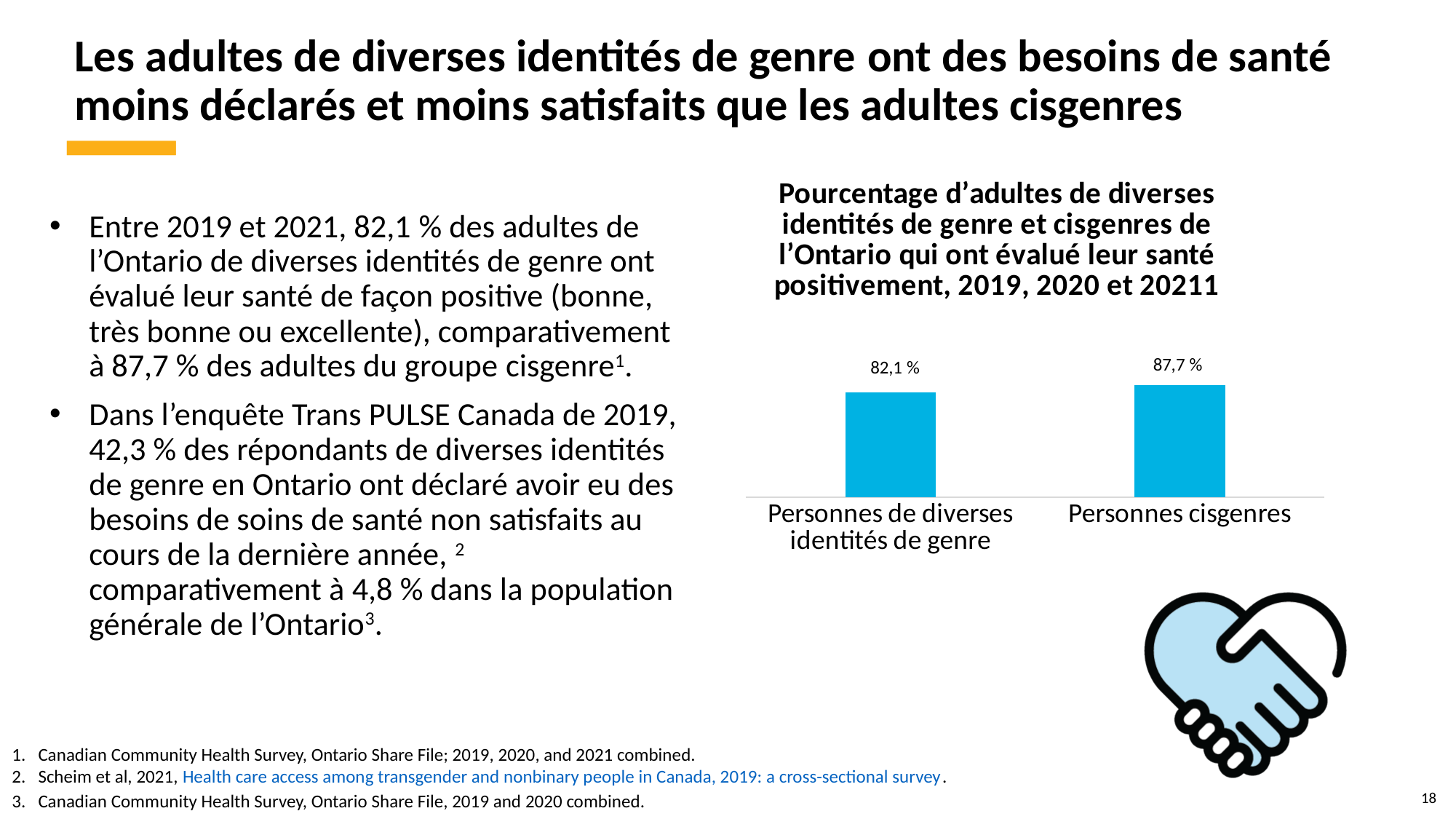
What kind of chart is shown on the slide? Bar chart Which is larger: the value for Personnes de diverses identités de genre or the value for Personnes cisgenres? Personnes cisgenres Which category has the lowest value? Personnes de diverses identités de genre What is the value for Personnes de diverses identités de genre? 82,1 % How many categories are shown in the chart? 2 What is the difference between the value for Personnes cisgenres and the value for Personnes de diverses identités de genre? 5,6 % What is the value for Personnes cisgenres? 87,7 % What colour are the bars in the chart? Blue Which category has the highest value? Personnes cisgenres What is the title of the chart? Pourcentage d’adultes de diverses identités de genre et cisgenres de l’Ontario qui ont évalué leur santé positivement, 2019, 2020 et 2021